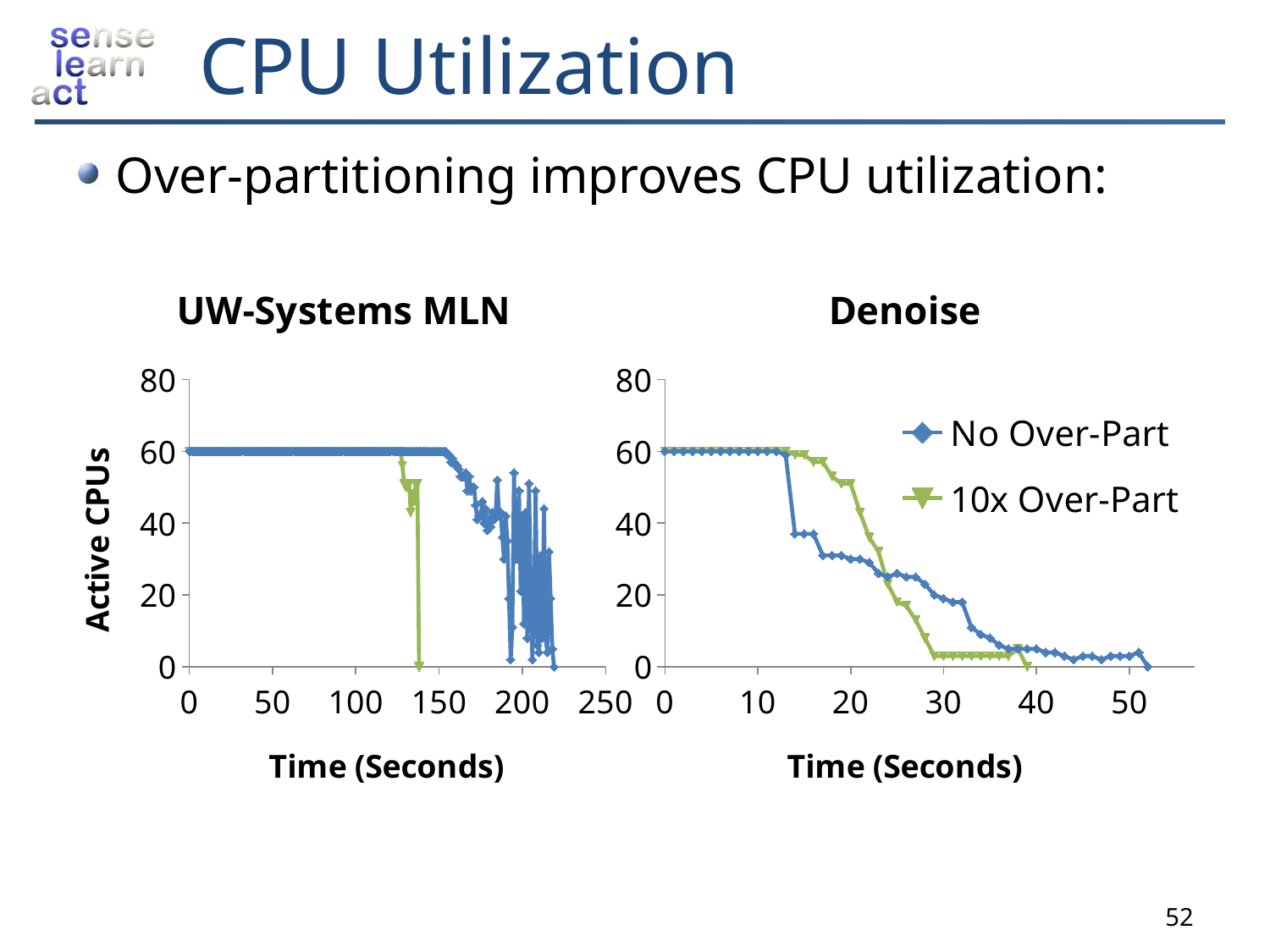
In the Denoise chart, do the 10x Over-Part values rise or fall as time increases? fall In the UW-Systems MLN chart, do the No Over-Part values rise or fall as time increases? fall What are the two series named in the legend of the Denoise chart? No Over-Part and 10x Over-Part In the Denoise chart, is the No Over-Part value at 20 seconds greater or less than 40? less In the Denoise chart, which series has the higher value at 30 seconds, No Over-Part or 10x Over-Part? No Over-Part In the UW-Systems MLN chart, is the No Over-Part value at 100 seconds greater or less than 40? greater In the Denoise chart, which series has the higher value at 20 seconds, No Over-Part or 10x Over-Part? 10x Over-Part In the UW-Systems MLN chart, which series drops to 0 active CPUs first, No Over-Part or 10x Over-Part? 10x Over-Part What is the label of the y axis on the UW-Systems MLN chart? Active CPUs How many series does the legend on the Denoise chart list? 2 What kind of chart is the UW-Systems MLN chart? line chart In the Denoise chart, is the 10x Over-Part value at 20 seconds greater or less than 40? greater